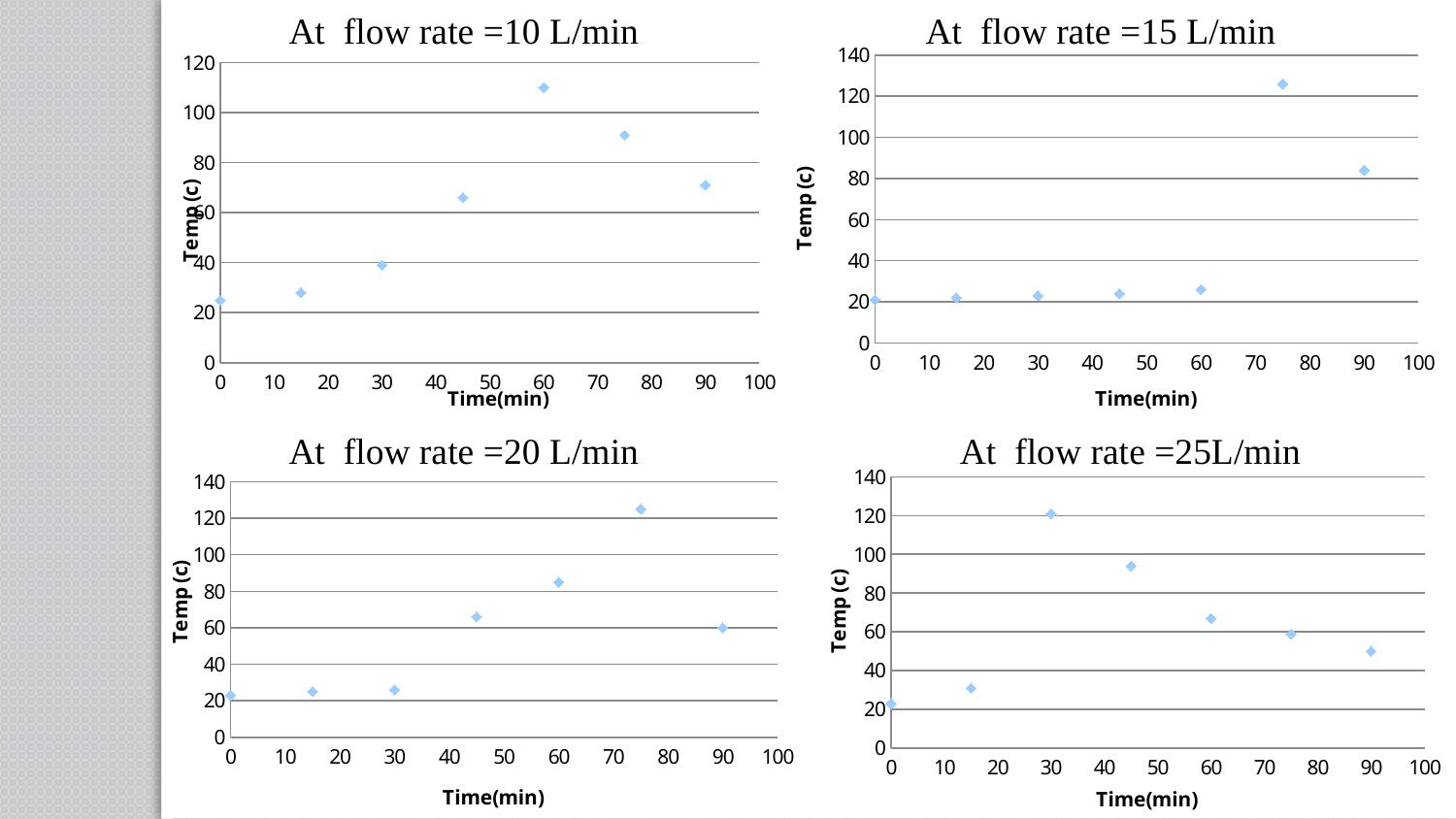
In the 'At flow rate =10 L/min' chart, is the temperature at 60 min greater or less than 100? greater What is the y-axis label on the 'At flow rate =25L/min' chart? Temp (c) In the 'At flow rate =15 L/min' chart, at which time is the temperature highest? 75 min In the 'At flow rate =10 L/min' chart, at which time is the temperature highest? 60 min In the 'At flow rate =25L/min' chart, at which time is the temperature highest? 30 min In the 'At flow rate =15 L/min' chart, is the temperature at 75 min greater or less than 120? greater What kind of chart is the 'At flow rate =10 L/min' chart? scatter chart In the 'At flow rate =25L/min' chart, is the temperature at 90 min greater or less than 60? less In the 'At flow rate =10 L/min' chart, how many data points are plotted? 7 In the 'At flow rate =10 L/min' chart, which has the higher temperature: 60 min or 90 min? 60 min